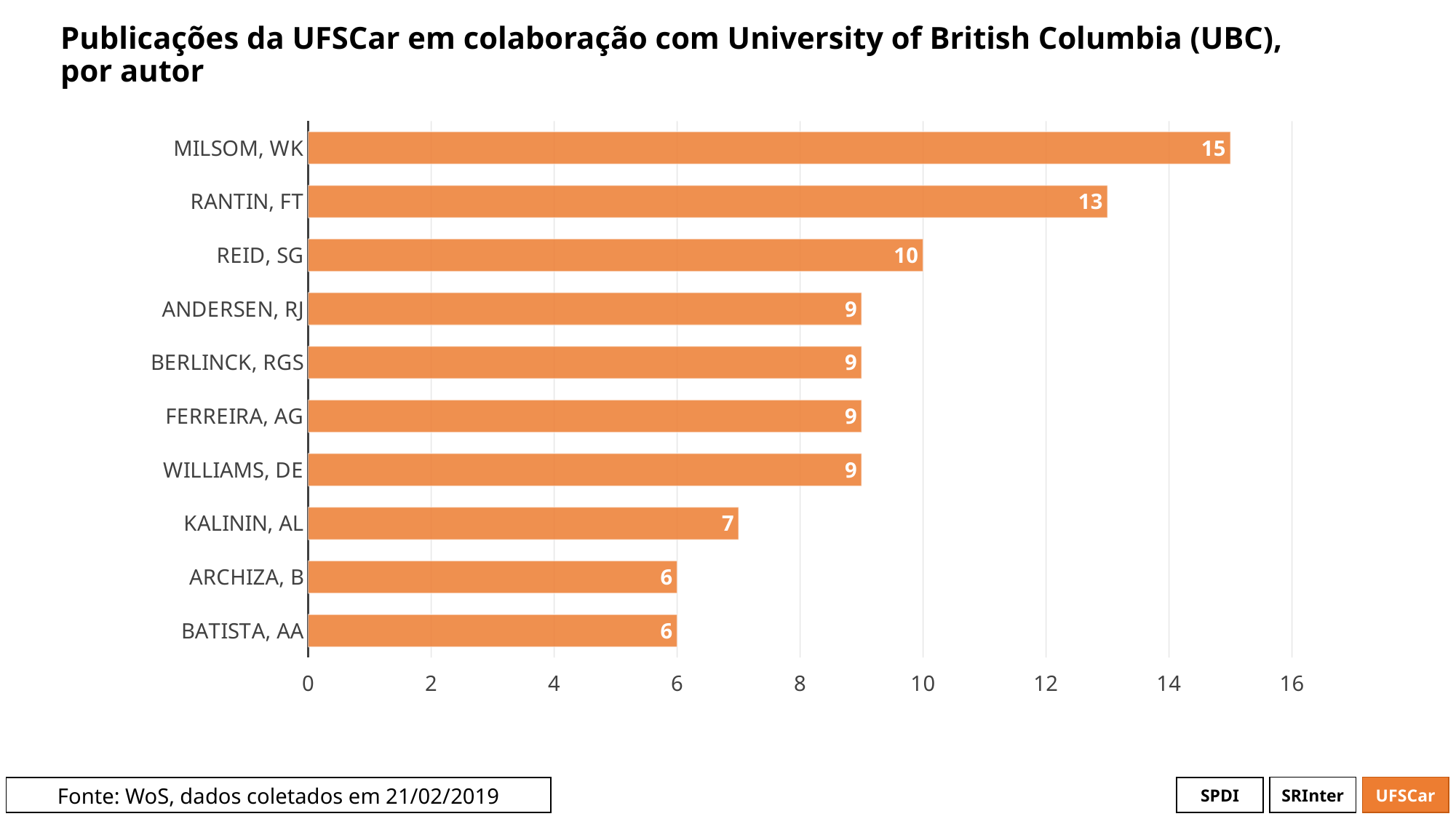
Which is larger, the value for RANTIN, FT or the value for ANDERSEN, RJ? RANTIN, FT Which author has the highest number of publications? MILSOM, WK What kind of chart is shown on the slide? bar chart What is the difference between the values for REID, SG and ARCHIZA, B? 4 How many publications does MILSOM, WK have? 15 How many authors are shown in the chart? 10 What is the value for KALININ, AL? 7 What is the difference between the values for MILSOM, WK and RANTIN, FT? 2 Is the value for RANTIN, FT greater or less than 12? greater How many authors have a value of 9? 4 What is the value for REID, SG? 10 What is the source of the data stated on the slide? WoS, dados coletados em 21/02/2019